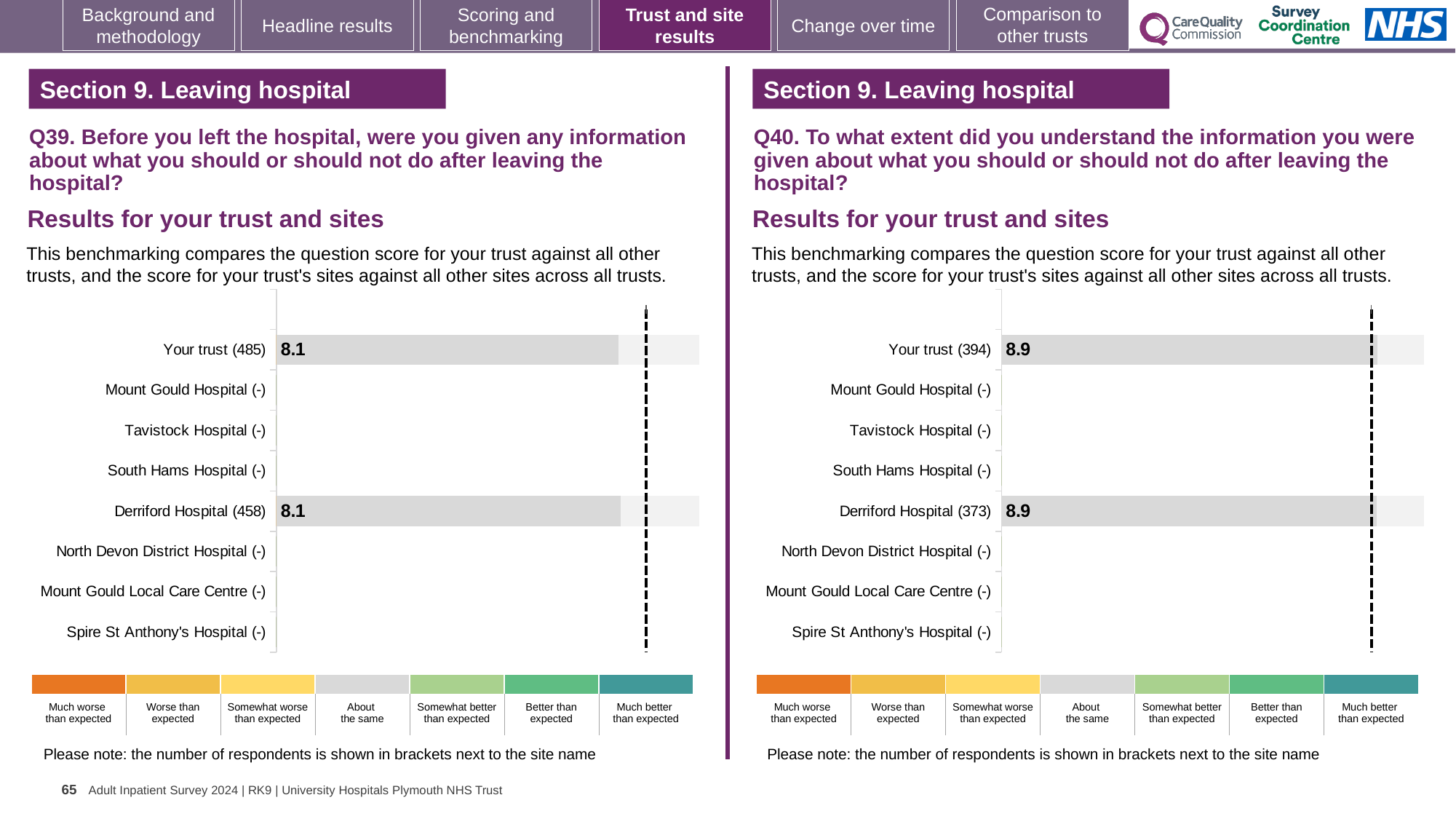
How many site/trust categories are listed on the Q39 chart (left)? 8 On the Q40 chart (right), what is the score for Derriford Hospital (373)? 8.9 On the Q40 chart (right), how many respondents are shown in brackets for Your trust? 394 On the Q40 chart (right), what is the score for Your trust (394)? 8.9 On the Q39 chart (left), what is the score for Your trust (485)? 8.1 How many site/trust categories are listed on the Q40 chart (right)? 8 On the Q39 chart (left), what is the score for Derriford Hospital (458)? 8.1 On the Q40 chart (right), what is the difference between the scores for Your trust and Derriford Hospital? 0 Is the Q40 (right) score for Your trust larger or smaller than the Q39 (left) score for Your trust? Larger On the Q39 chart (left), how many respondents are shown in brackets for Derriford Hospital? 458 On the Q39 chart (left), what is the difference between the scores for Your trust and Derriford Hospital? 0 What kind of chart is the Q39 chart (left)? Bar chart